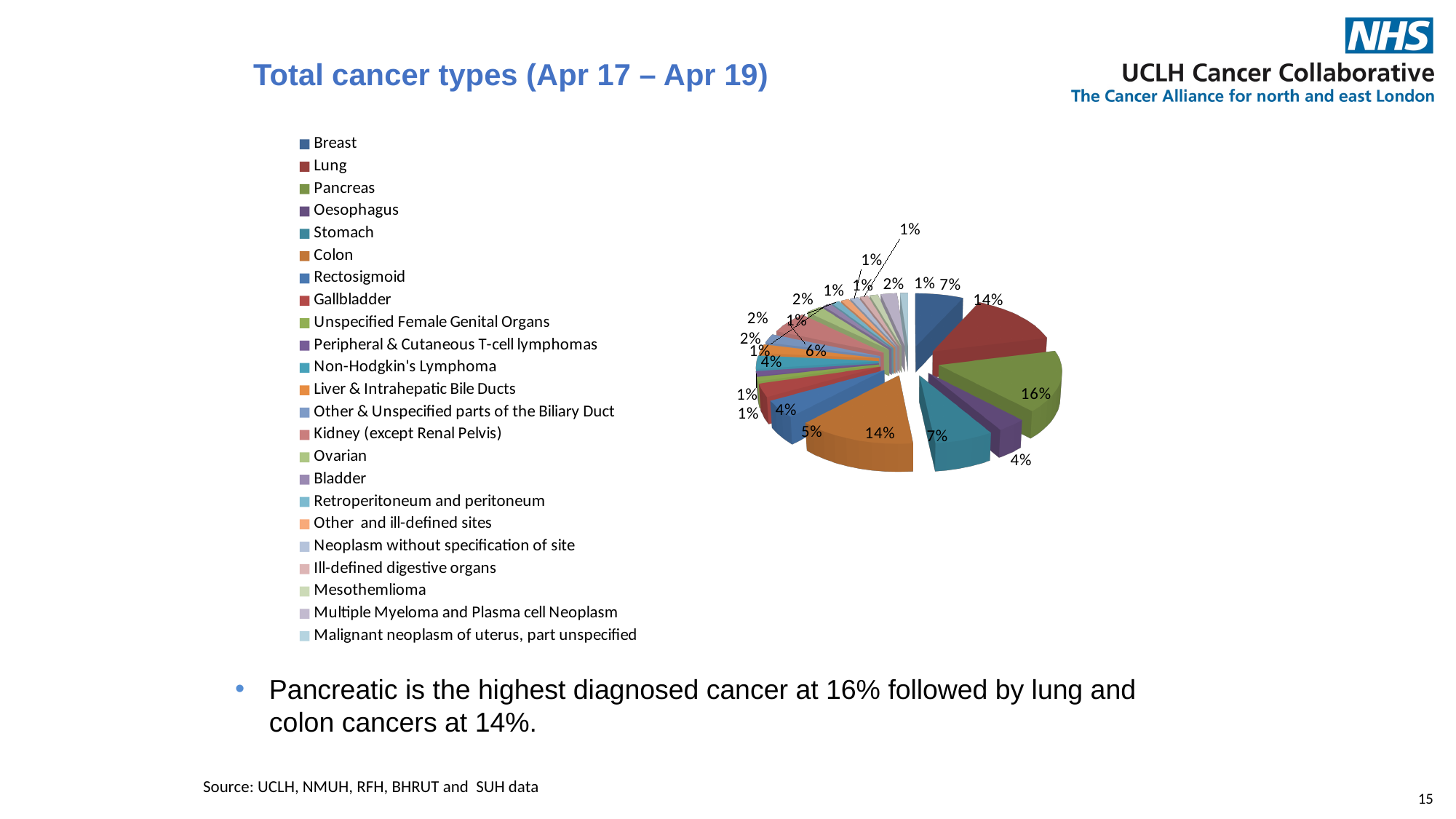
How many cancer types are listed in the legend? 23 What kind of chart is shown on the slide? Pie chart What share of the pie does Lung have? 14% What is the difference in percentage points between the Pancreas share and the Lung share? 2 percentage points Which cancer type has the largest share of the pie? Pancreas What colour is the Pancreas slice in the pie chart? Green What share of the pie does Stomach have? 7% What share of the pie does Pancreas have? 16% What is the title of the chart? Total cancer types (Apr 17 – Apr 19) Which has the larger share, Breast or Oesophagus? Breast